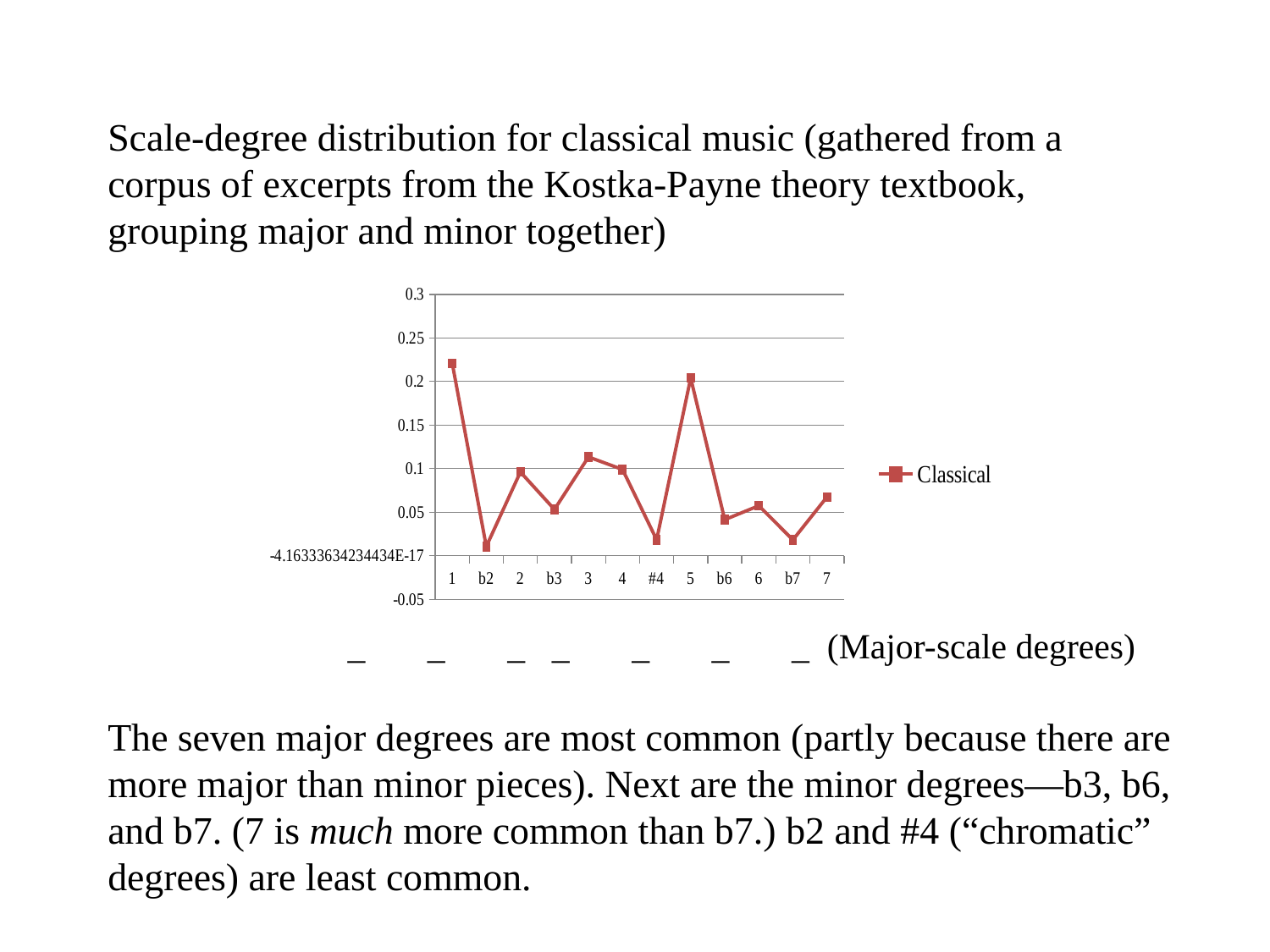
What kind of chart is shown on the slide? line chart Is the value for scale degree 1 greater or less than 0.2? greater Which scale degree has the highest value? 1 Is the value for scale degree #4 greater or less than 0.05? less How many scale-degree categories are plotted along the x axis? 12 Is the value for scale degree 7 greater or less than 0.05? greater What is the name of the series shown in the legend? Classical Which has the larger value, scale degree 3 or scale degree b3? 3 Which has the larger value, scale degree 7 or scale degree b7? 7 How many series does the legend list? 1